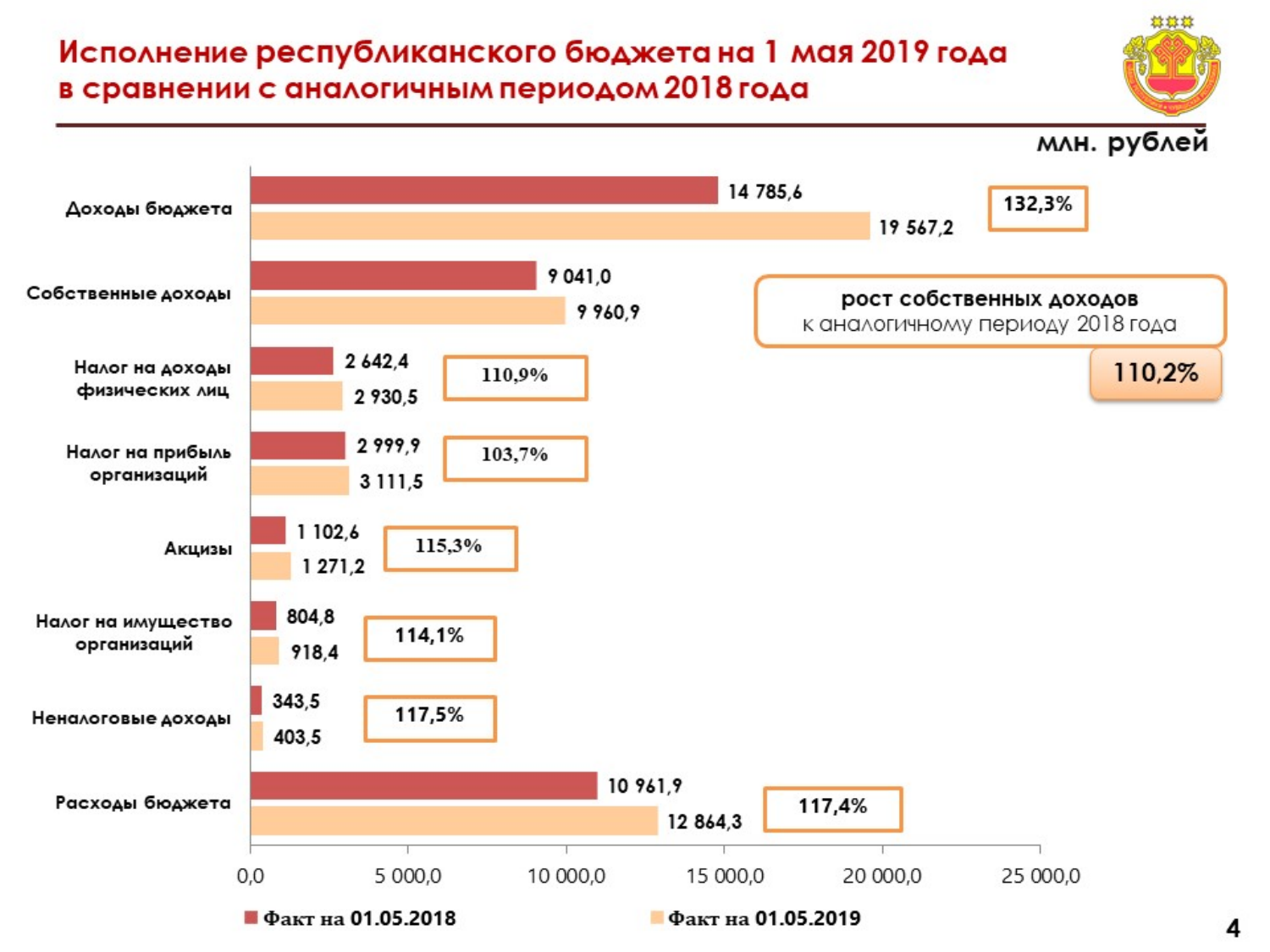
Which is larger for Собственные доходы: the Факт на 01.05.2018 value or the Факт на 01.05.2019 value? Факт на 01.05.2019 What is the value for Акцизы in the Факт на 01.05.2019 series? 1 271,2 How many series does the legend list? 2 How many categories are shown on the chart? 8 What is the value for Доходы бюджета in the Факт на 01.05.2019 series? 19 567,2 Which category has the highest value in the Факт на 01.05.2019 series? Доходы бюджета What is the value for Расходы бюджета in the Факт на 01.05.2018 series? 10 961,9 What kind of chart is shown on the slide? bar chart Which category has the lowest value in the Факт на 01.05.2018 series? Неналоговые доходы Is the Факт на 01.05.2019 value for Собственные доходы greater or less than 10 000,0? less What is the difference between the Факт на 01.05.2019 and Факт на 01.05.2018 values for Расходы бюджета? 1 902,4 What is the difference between the Факт на 01.05.2019 and Факт на 01.05.2018 values for Доходы бюджета? 4 781,6